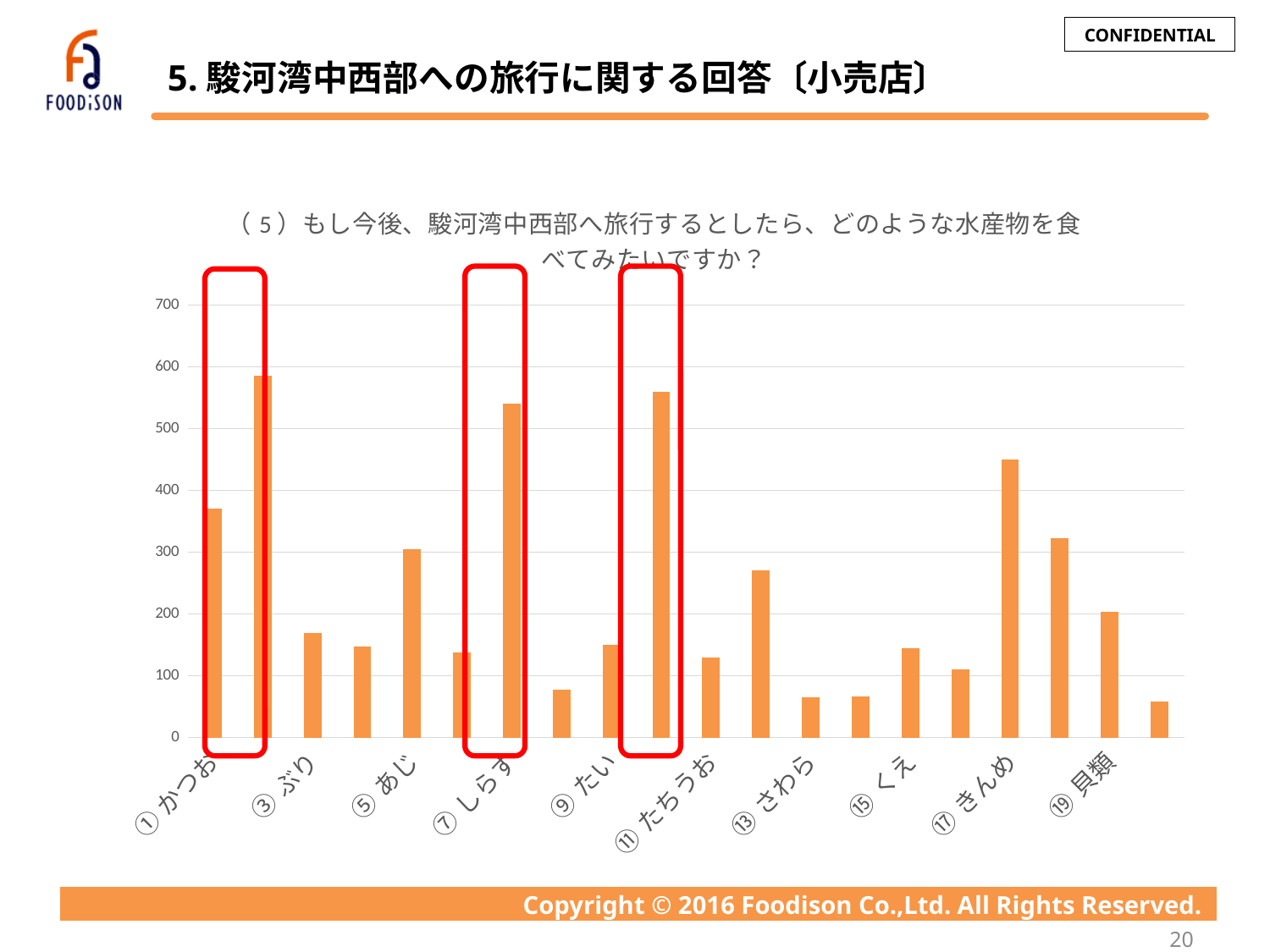
Which has a larger value, ⑦しらす or ⑰きんめ? ⑦しらす What is the highest value shown on the vertical axis of the chart? 700 Is the value for ①かつお greater or less than 300? greater How many red boxes are drawn around bars in the chart? 3 Is the value for ⑦しらす greater or less than 500? greater Is the value for ⑨たい greater or less than 200? less Which has a larger value, ⑤あじ or ⑪たちうお? ⑤あじ What kind of chart is shown on the slide? bar chart How many bars are plotted in the chart? 20